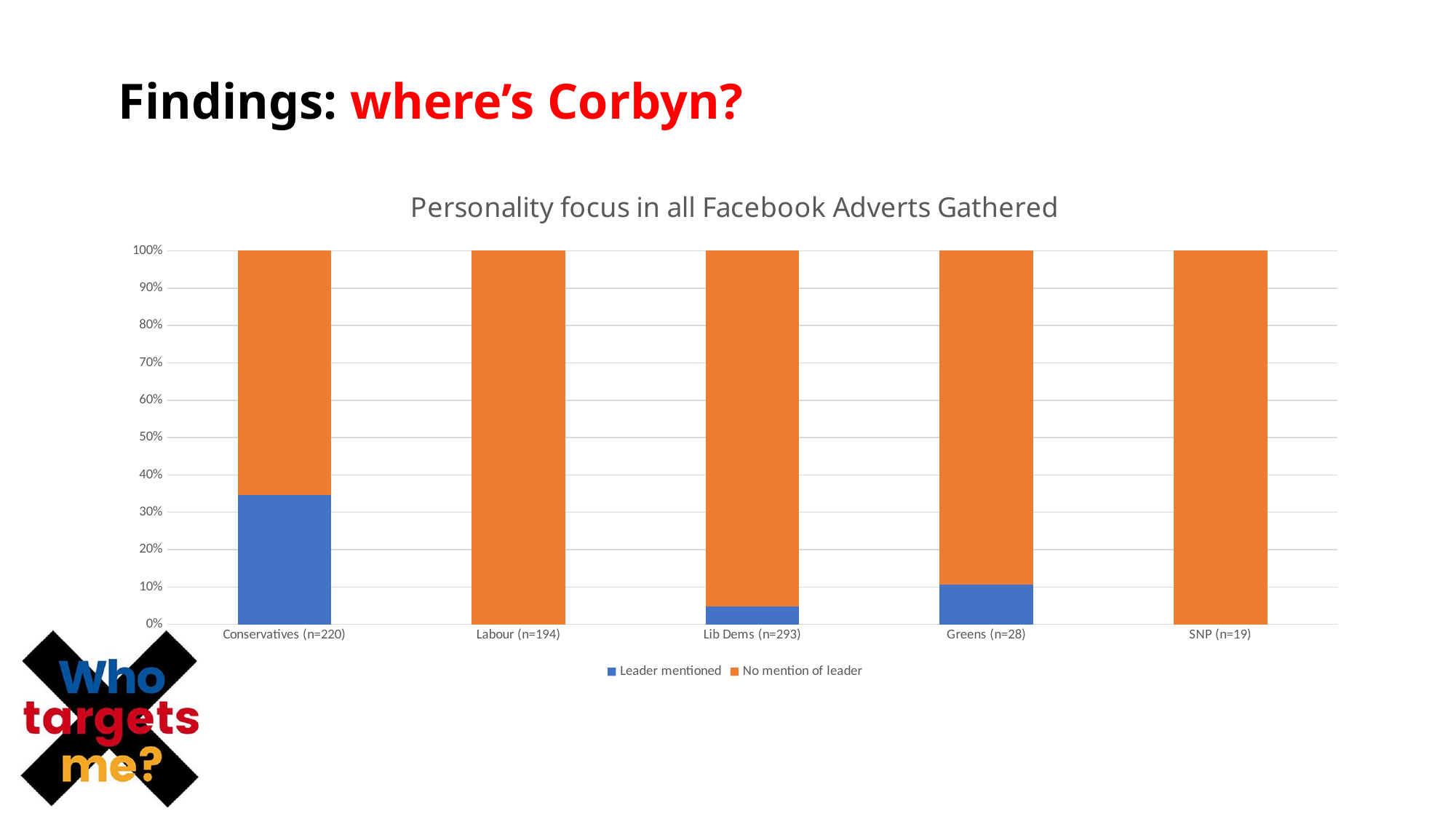
Is the 'Leader mentioned' value for Conservatives (n=220) greater or less than 30%? greater Which category has the highest share of 'Leader mentioned'? Conservatives (n=220) How many series does the legend list? 2 How many categories (parties) are shown on the x axis? 5 What is the title of the chart? Personality focus in all Facebook Adverts Gathered What kind of chart is shown on the slide? Stacked bar chart What are the two series named in the legend? Leader mentioned; No mention of leader What is the total height of the stacked bar for Labour (n=194)? 100% Is the 'Leader mentioned' value for Greens (n=28) greater or less than 20%? less Which has a larger 'Leader mentioned' share, Greens (n=28) or Lib Dems (n=293)? Greens (n=28) Is the 'Leader mentioned' value for Conservatives (n=220) greater or less than 40%? less